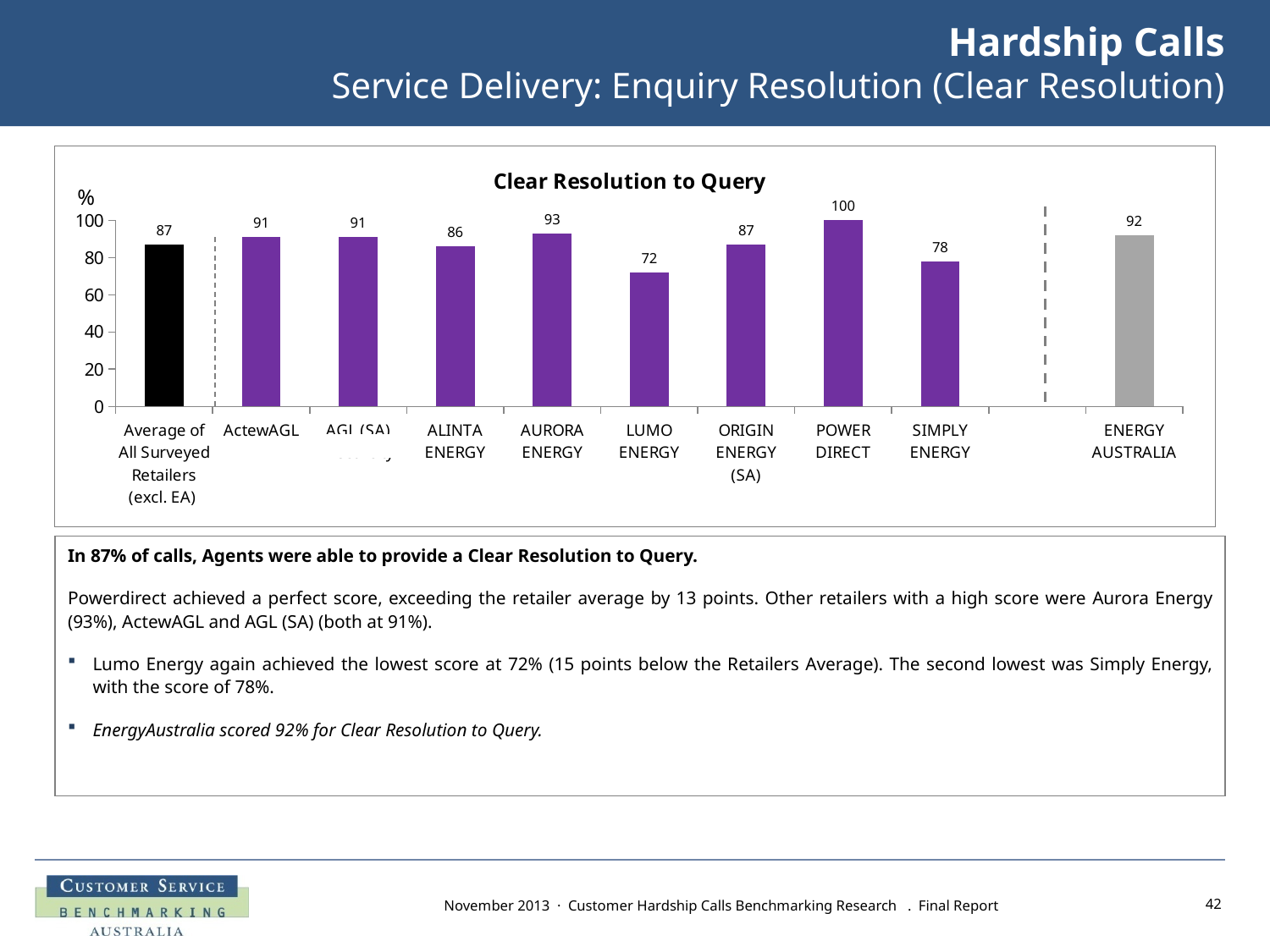
Which has a higher value, ALINTA ENERGY or ActewAGL? ActewAGL What is the title of the chart on the slide? Clear Resolution to Query What is the value for POWER DIRECT in the Clear Resolution to Query chart? 100 What kind of chart is shown on the slide? Bar chart What is the value for the Average of All Surveyed Retailers (excl. EA) in the chart? 87 How many bars are plotted in the Clear Resolution to Query chart? 10 What is the value for ENERGY AUSTRALIA in the Clear Resolution to Query chart? 92 What is the value for LUMO ENERGY in the Clear Resolution to Query chart? 72 Which category has the highest value in the Clear Resolution to Query chart? POWER DIRECT Which category has the lowest value in the Clear Resolution to Query chart? LUMO ENERGY What is the difference between the values for POWER DIRECT and LUMO ENERGY? 28 What is the difference between the values for AURORA ENERGY and SIMPLY ENERGY? 15